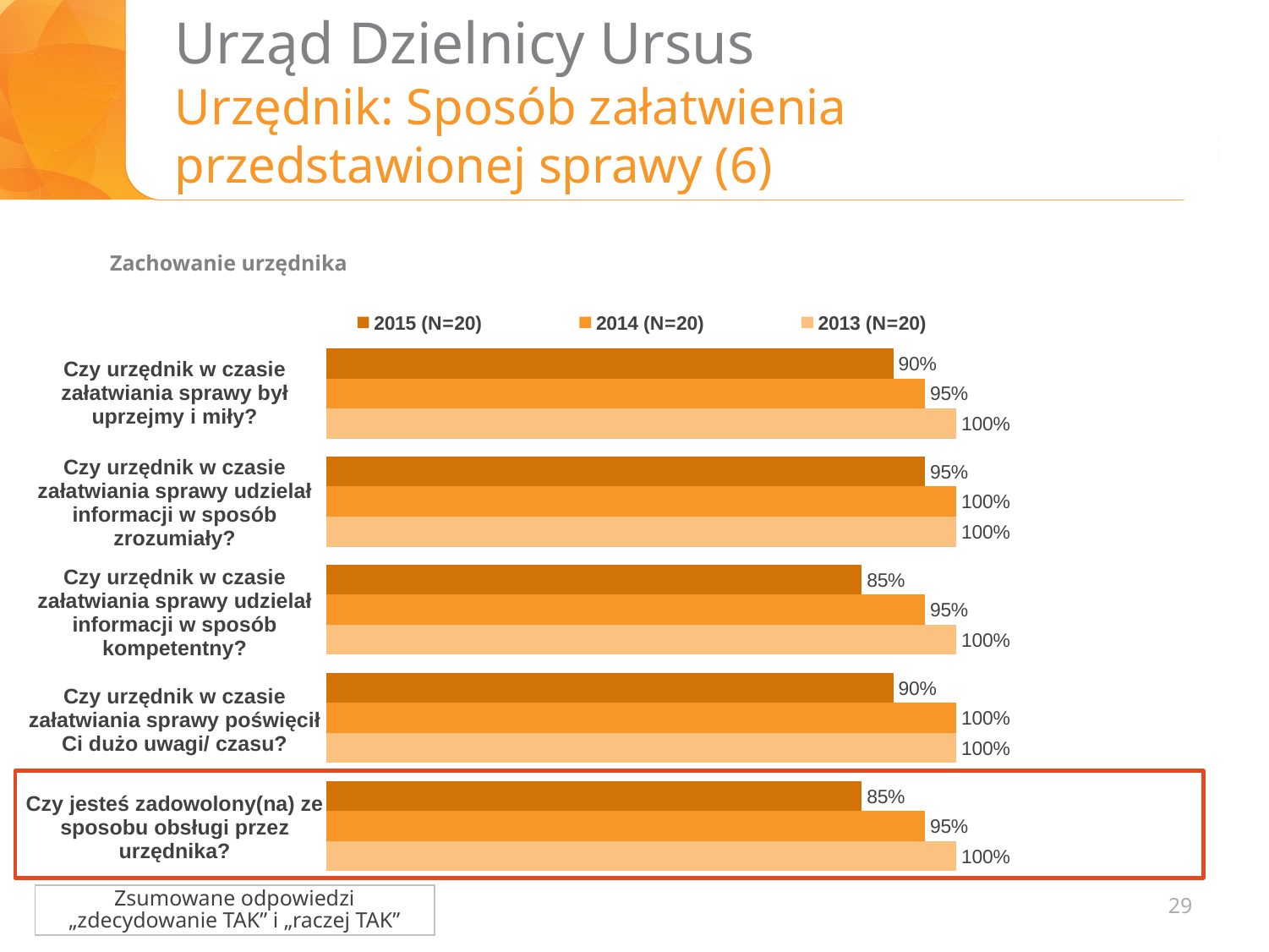
For "Czy urzędnik w czasie załatwiania sprawy poświęcił Ci dużo uwagi/ czasu?", which is larger: the 2015 (N=20) value or the 2014 (N=20) value? 2014 (N=20) What is the 2015 (N=20) value for "Czy urzędnik w czasie załatwiania sprawy był uprzejmy i miły?"? 90% What is the 2014 (N=20) value for "Czy jesteś zadowolony(na) ze sposobu obsługi przez urzędnika?"? 95% What is the difference between the 2014 (N=20) and 2015 (N=20) values for "Czy urzędnik w czasie załatwiania sprawy udzielał informacji w sposób kompetentny?"? 10% Which series is shown in the lightest orange colour in the legend? 2013 (N=20) Which category has the highest 2015 (N=20) value? Czy urzędnik w czasie załatwiania sprawy udzielał informacji w sposób zrozumiały? How many series does the legend list? 3 What is the 2013 (N=20) value for "Czy urzędnik w czasie załatwiania sprawy udzielał informacji w sposób kompetentny?"? 100% What is the 2015 (N=20) value for "Czy urzędnik w czasie załatwiania sprawy udzielał informacji w sposób zrozumiały?"? 95% What kind of chart is shown on the slide? Bar chart What is the difference between the 2013 (N=20) and 2015 (N=20) values for "Czy jesteś zadowolony(na) ze sposobu obsługi przez urzędnika?"? 15% How many question categories are plotted in the chart? 5